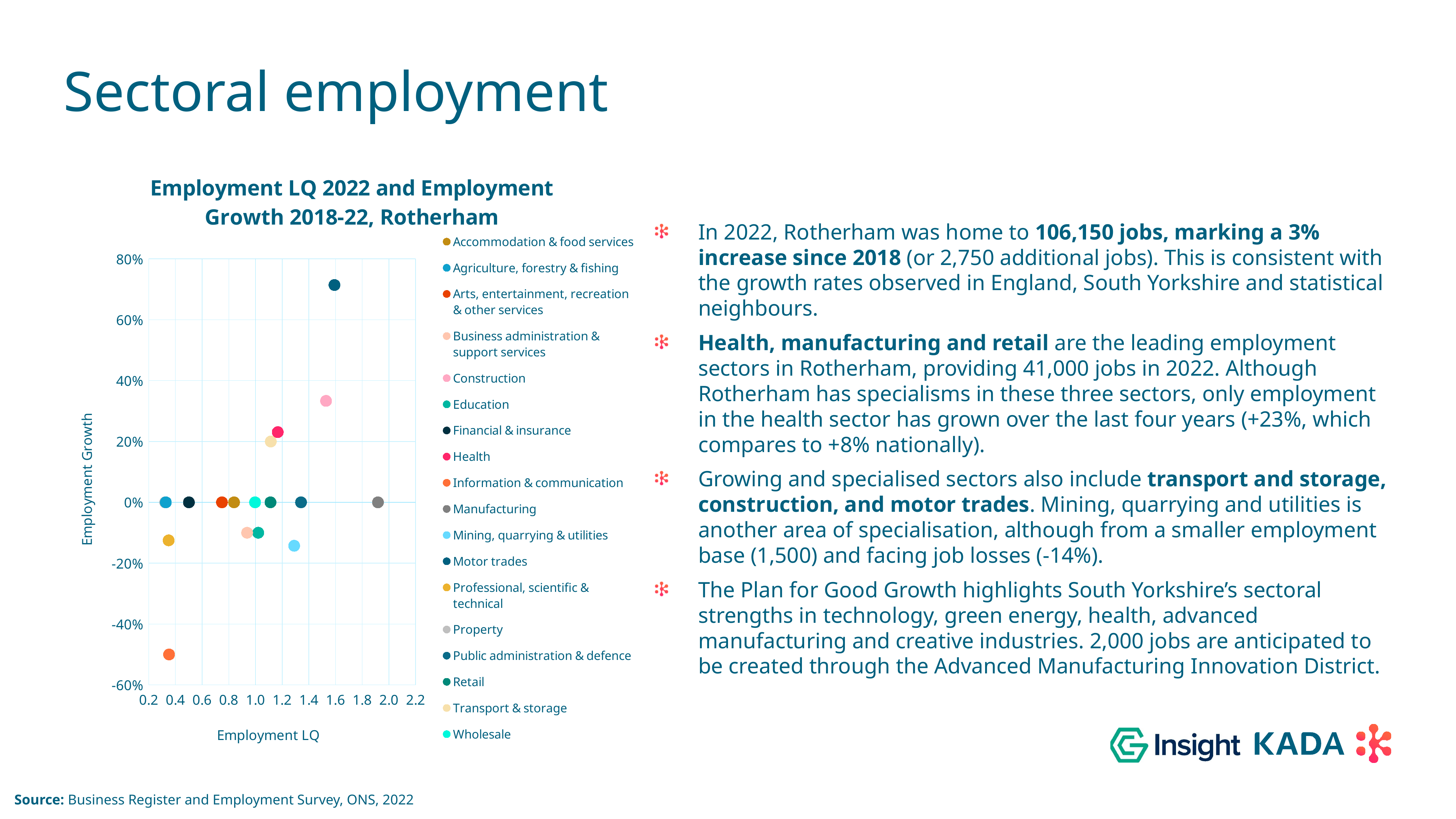
Is the employment growth for Construction greater or less than 20%? greater Is the Employment LQ for Manufacturing greater or less than 1.6? greater Is the employment growth for Information & communication greater or less than -40%? less Which has the higher employment growth, Construction or Health? Construction Which sector has the lowest employment growth in the chart? Information & communication What is the label of the horizontal axis of the chart? Employment LQ What kind of chart is shown on the slide? Scatter chart What is the title of the chart? Employment LQ 2022 and Employment Growth 2018-22, Rotherham How many sectors does the chart legend list? 18